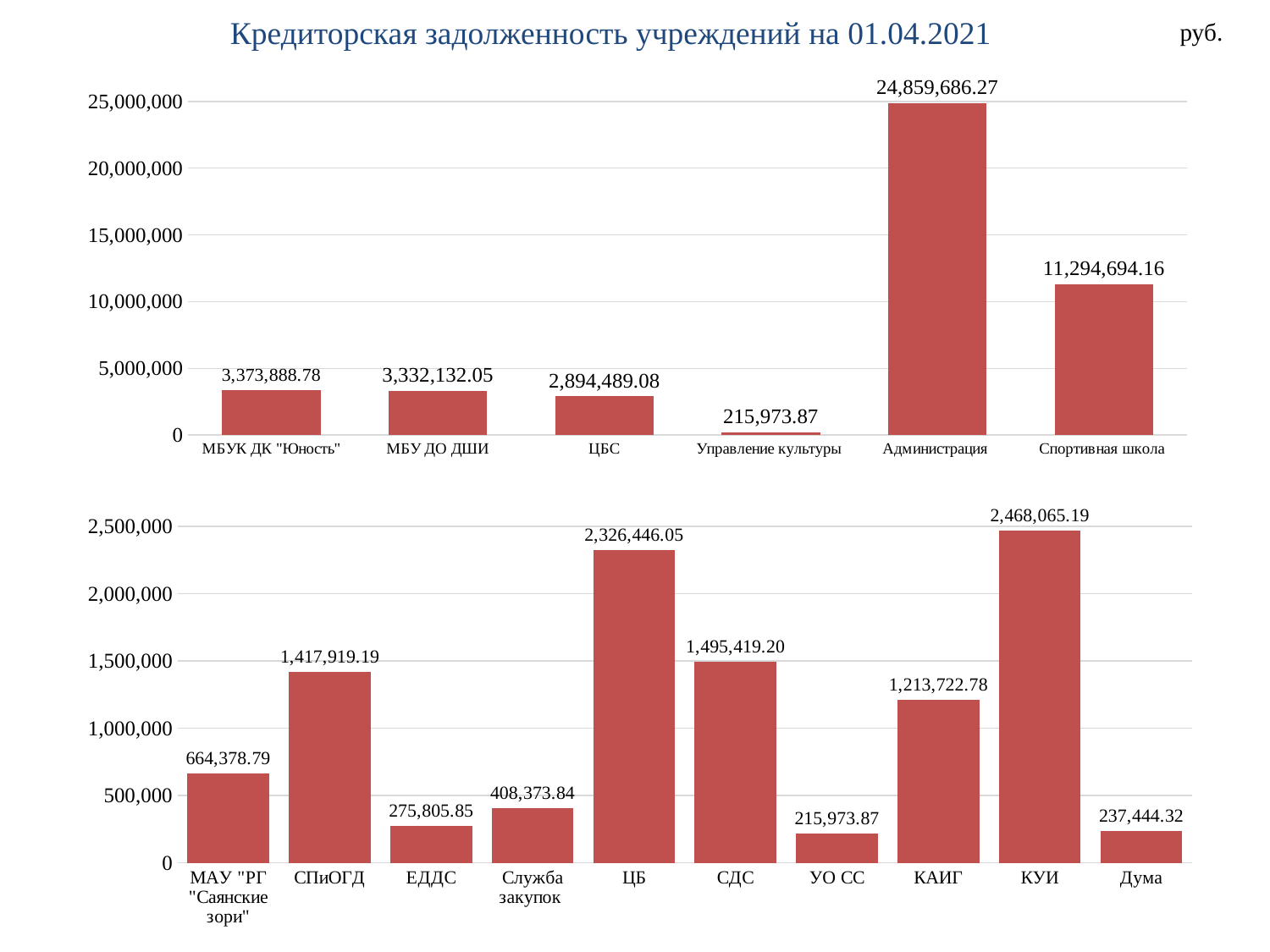
In the bottom chart, which is larger: the value for СДС or the value for СПиОГД? СДС In the bottom chart, which category has the highest value? КУИ In the top chart, which category has the highest value? Администрация In the bottom chart, what is the value for КАИГ? 1,213,722.78 In the top chart, is the value for Спортивная школа greater or less than 10,000,000? greater In the top chart, what is the difference between the values for Администрация and Спортивная школа? 13,564,992.11 What type of chart is the top chart? bar chart In the top chart, what is the value for Администрация? 24,859,686.27 In the bottom chart, which category has the lowest value? УО СС How many categories are shown in the bottom chart? 10 In the top chart, what is the value for Управление культуры? 215,973.87 In the bottom chart, what is the value for Служба закупок? 408,373.84